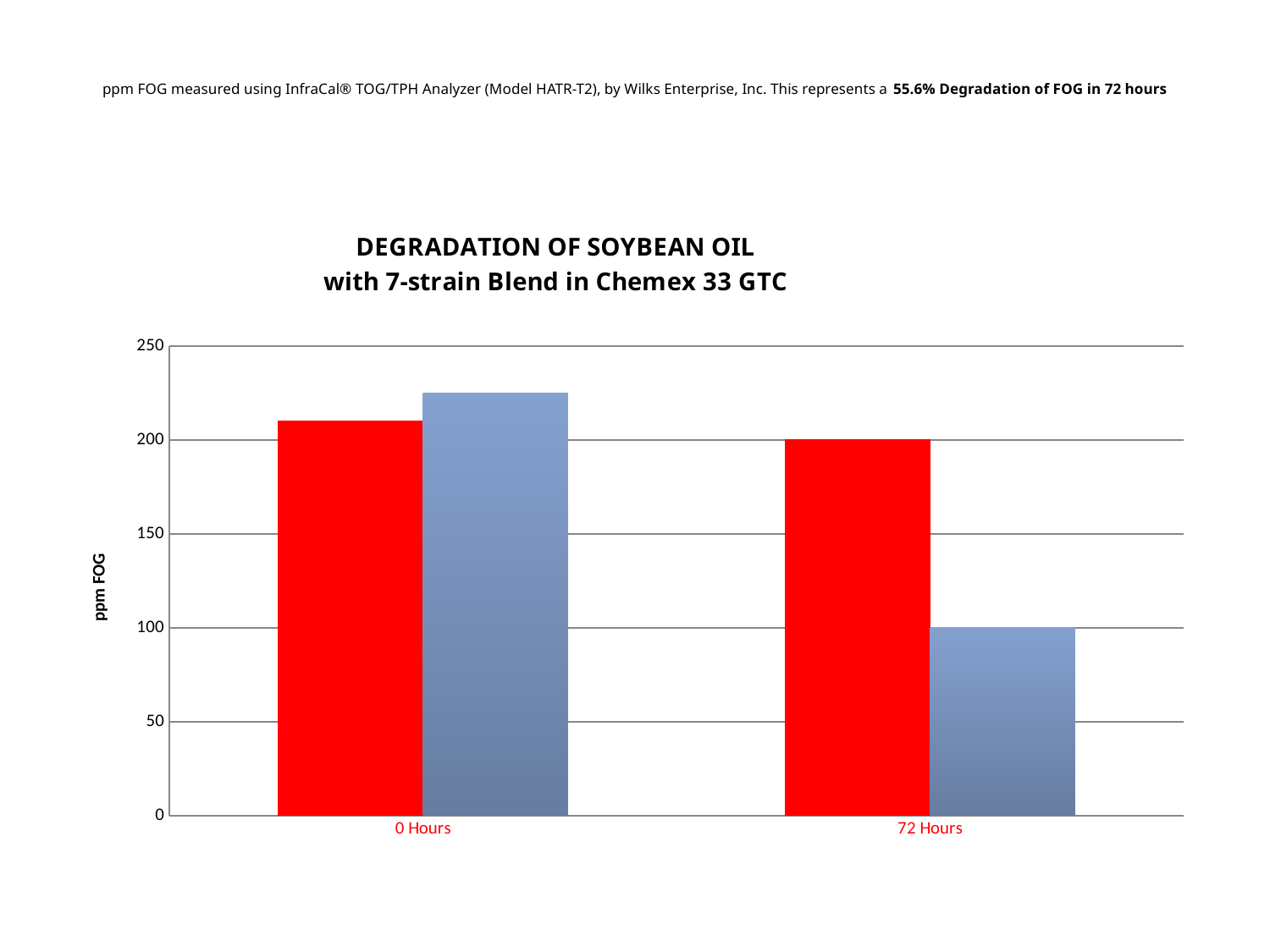
Is the value of the blue bar at 0 Hours greater or less than 200? greater What is the value of the blue bar at 72 Hours? 100 Does the blue bar rise or fall from 0 Hours to 72 Hours? fall What is the value of the red bar at 72 Hours? 200 How many categories are shown on the x axis? 2 At 72 Hours, which bar is taller, the red bar or the blue bar? the red bar Is the value of the blue bar at 0 Hours greater or less than 250? less What is the difference between the red bar and the blue bar at 72 Hours? 100 What type of chart is shown on the slide? bar chart What is the label on the y axis of the chart? ppm FOG Is the value of the red bar at 0 Hours greater or less than 200? greater At 0 Hours, which bar is taller, the red bar or the blue bar? the blue bar